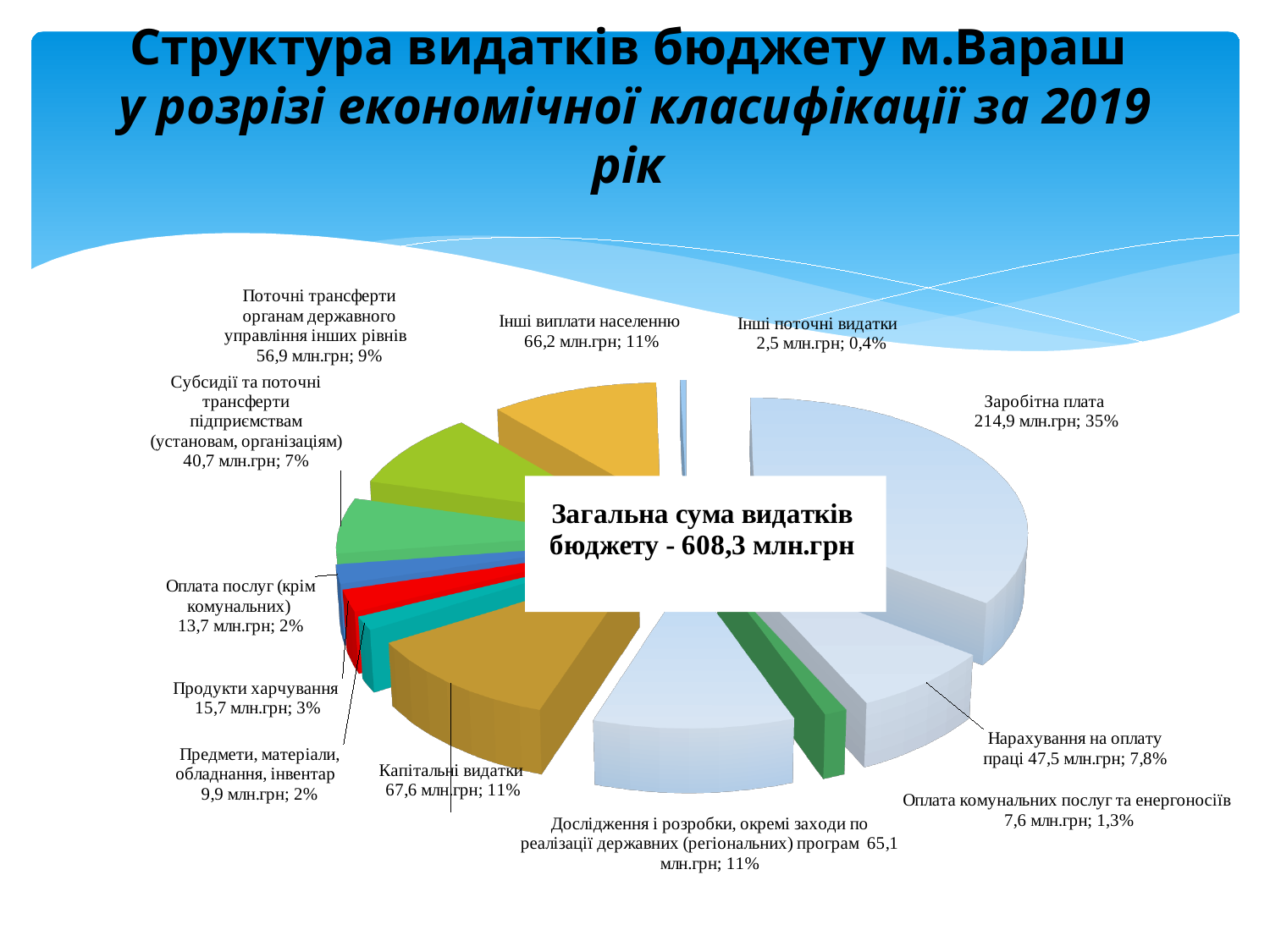
Which is larger: Продукти харчування or Оплата послуг (крім комунальних)? Продукти харчування What kind of chart is shown on the slide? pie chart What is the difference between Капітальні видатки and Інші виплати населенню? 1,4 млн.грн What is the value for Капітальні видатки? 67,6 млн.грн What share of the pie does Заробітна плата represent? 35% What is the value for Оплата комунальних послуг та енергоносіїв? 7,6 млн.грн Which category has the largest slice of the pie? Заробітна плата What is the value for Заробітна плата? 214,9 млн.грн Which category has the smallest slice of the pie? Інші поточні видатки What is the total sum of budget expenditures stated on the chart? 608,3 млн.грн How many categories are shown in the pie chart? 12 What share of the pie does Нарахування на оплату праці represent? 7,8%